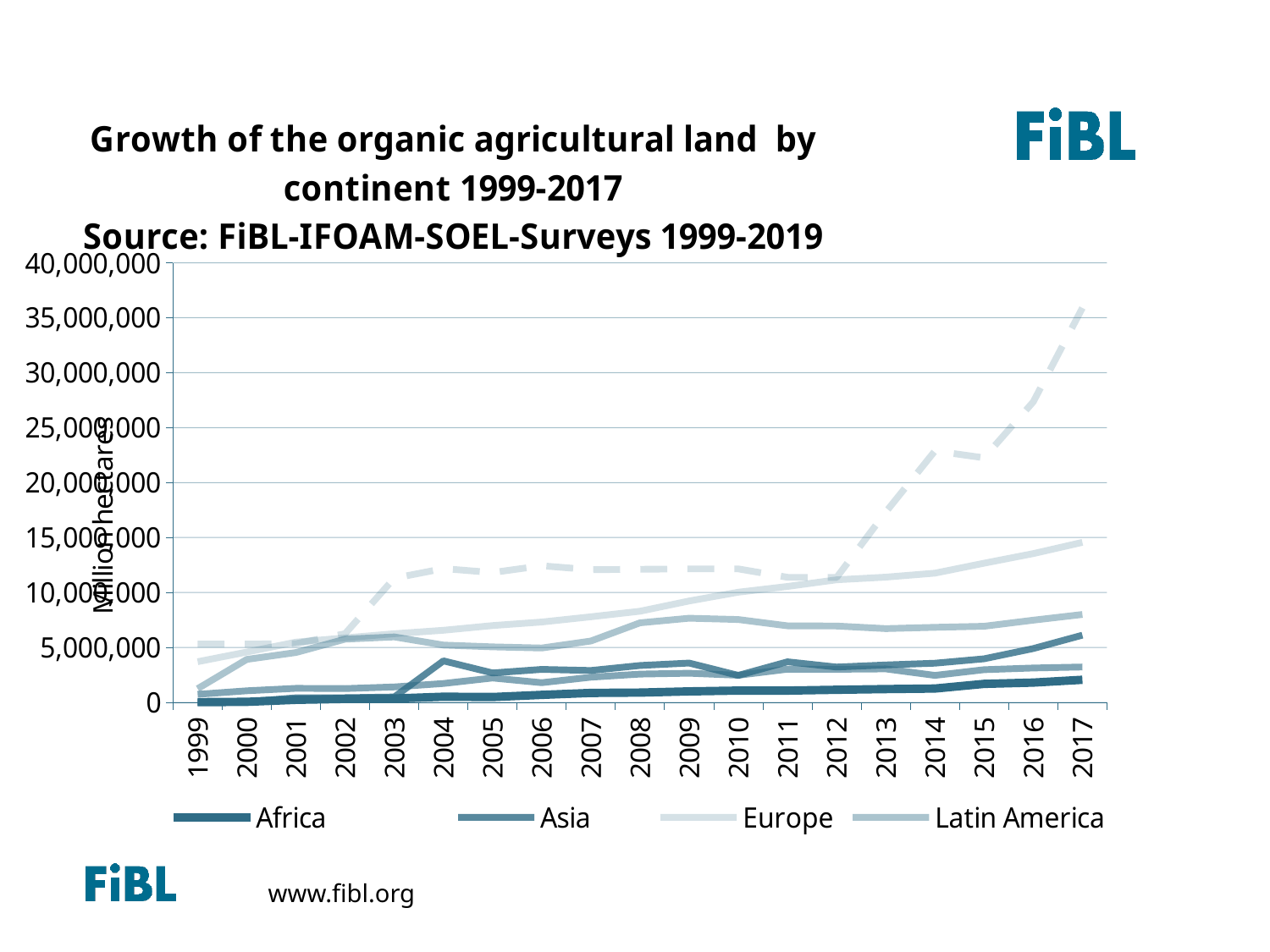
Is the value for Europe in 2017 greater or less than 10,000,000? greater How many series does the legend list? 4 Is the value for Europe in 1999 greater or less than 10,000,000? less Is the value for Latin America in 2017 greater or less than 5,000,000? greater Does the value for Europe rise or fall from 1999 to 2017? rise Which year is the first on the x axis? 1999 In 2017, is the value for Europe or for Africa larger? Europe What kind of chart is shown on the slide? line chart Which of the legend series has the lowest value in 2017? Africa Which of the legend series has the highest value in 2017? Europe How many years are shown along the x axis? 19